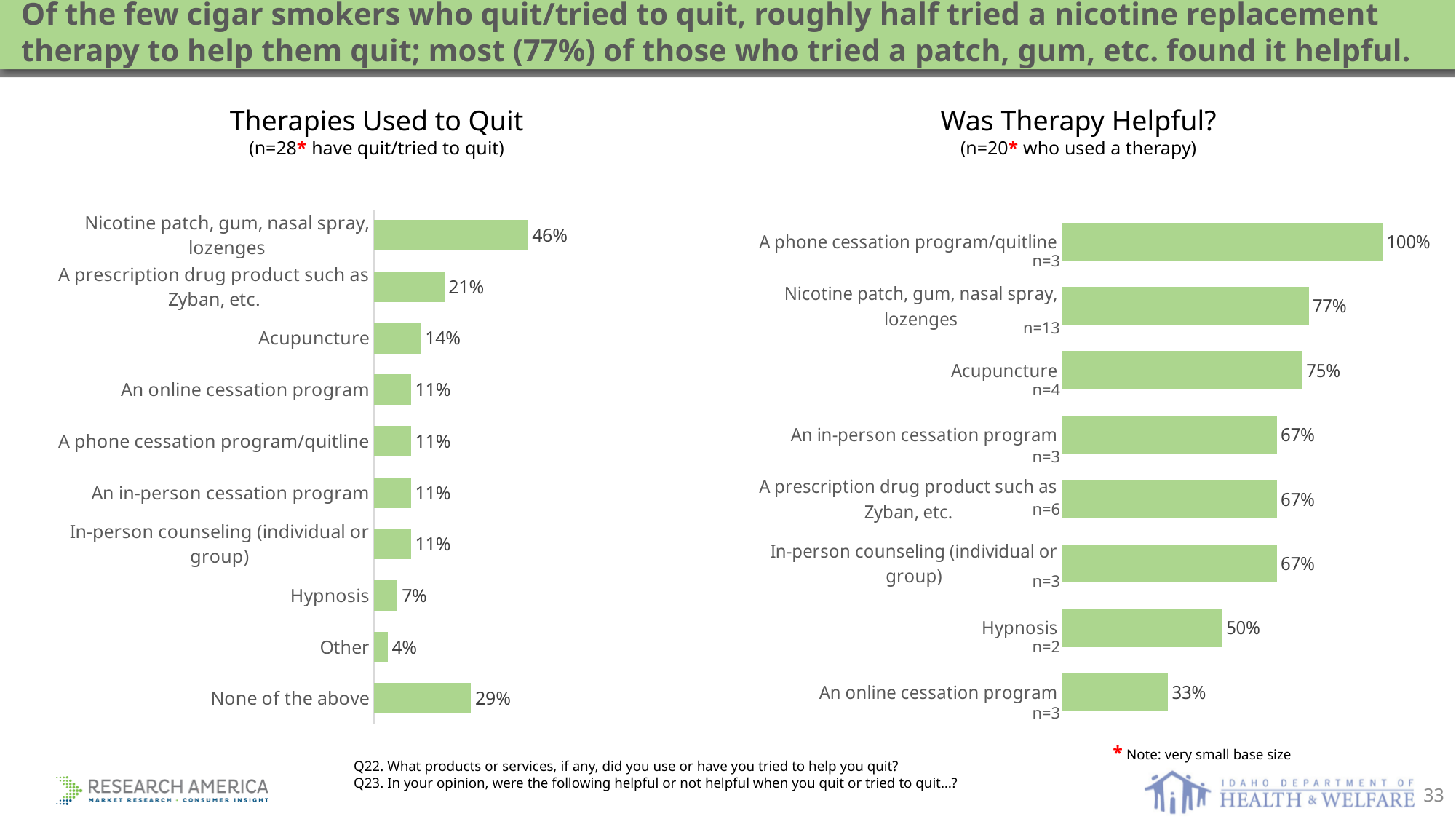
In the 'Was Therapy Helpful?' chart, what percentage found an online cessation program helpful? 33% In the 'Therapies Used to Quit' chart, which therapy has the lowest percentage (excluding 'None of the above')? Other In the 'Therapies Used to Quit' chart, what percentage used nicotine patch, gum, nasal spray, lozenges? 46% In the 'Was Therapy Helpful?' chart, what percentage found a phone cessation program/quitline helpful? 100% In the 'Was Therapy Helpful?' chart, which therapy has the lowest percentage? An online cessation program In the 'Was Therapy Helpful?' chart, what is the difference between the value for nicotine patch, gum, nasal spray, lozenges and the value for Hypnosis? 27% In the 'Was Therapy Helpful?' chart, what is the base size (n) shown for nicotine patch, gum, nasal spray, lozenges? n=13 In the 'Therapies Used to Quit' chart, what percentage selected 'None of the above'? 29% In the 'Was Therapy Helpful?' chart, which is larger: the value for Acupuncture or the value for Hypnosis? Acupuncture In the 'Therapies Used to Quit' chart, what is the difference between the nicotine patch, gum, nasal spray, lozenges value and the prescription drug product value? 25% What type of chart is the 'Therapies Used to Quit' chart? Bar chart In the 'Therapies Used to Quit' chart, how many categories are shown? 10